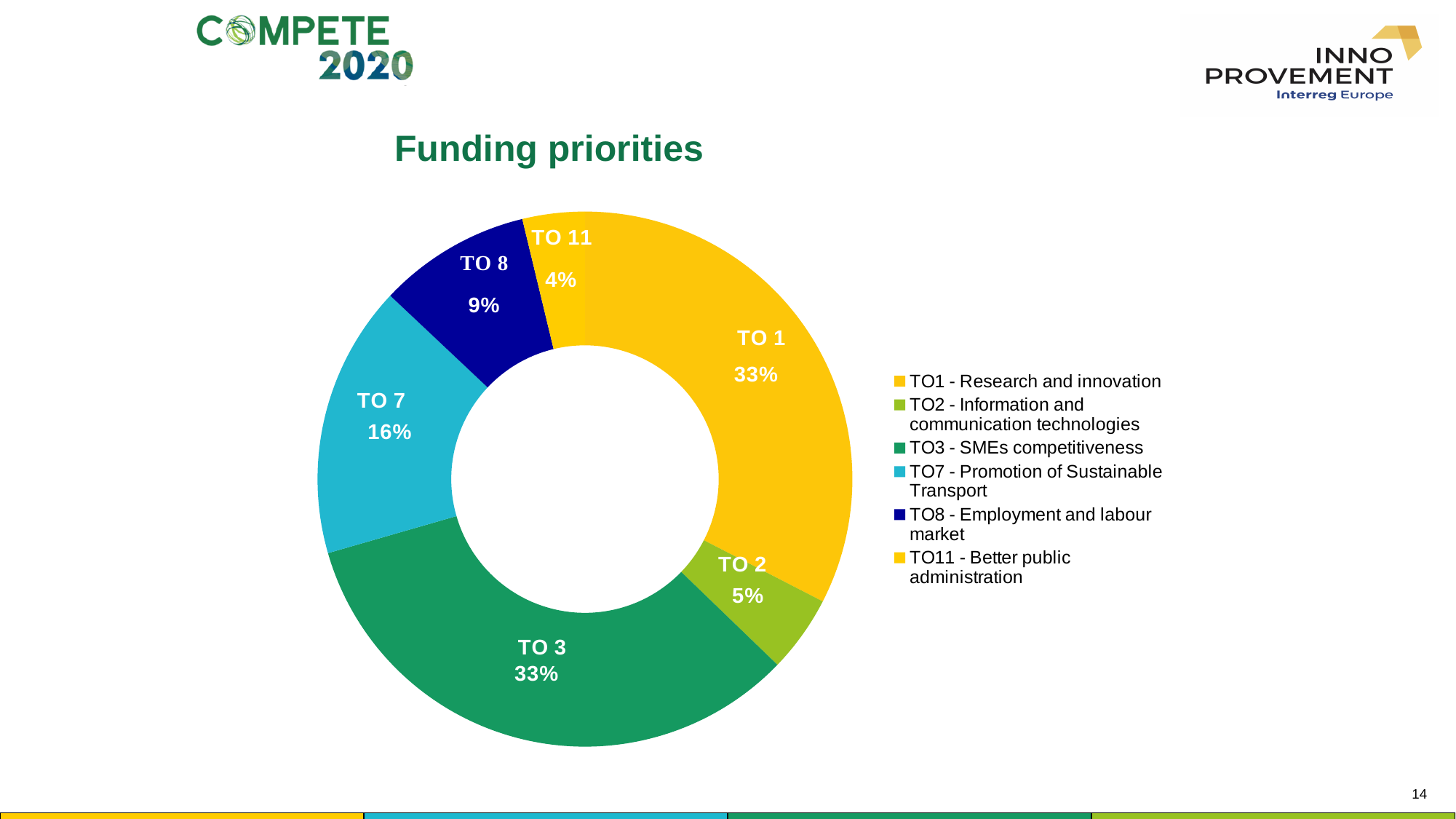
What share of funding does TO 1 receive? 33% Which is larger, the share for TO 2 or the share for TO 11? TO 2 What is the value shown for TO 8? 9% What is the title of the chart? Funding priorities How many entries does the legend list? 6 What percentage is shown for TO 7? 16% What percentage is shown for TO 2? 5% According to the legend, what does TO3 stand for? SMEs competitiveness What is the difference in percentage points between TO 7 and TO 8? 7 What kind of chart is shown on the slide? Doughnut (pie) chart How many slices does the chart have? 6 Which category has the smallest share of the chart? TO 11